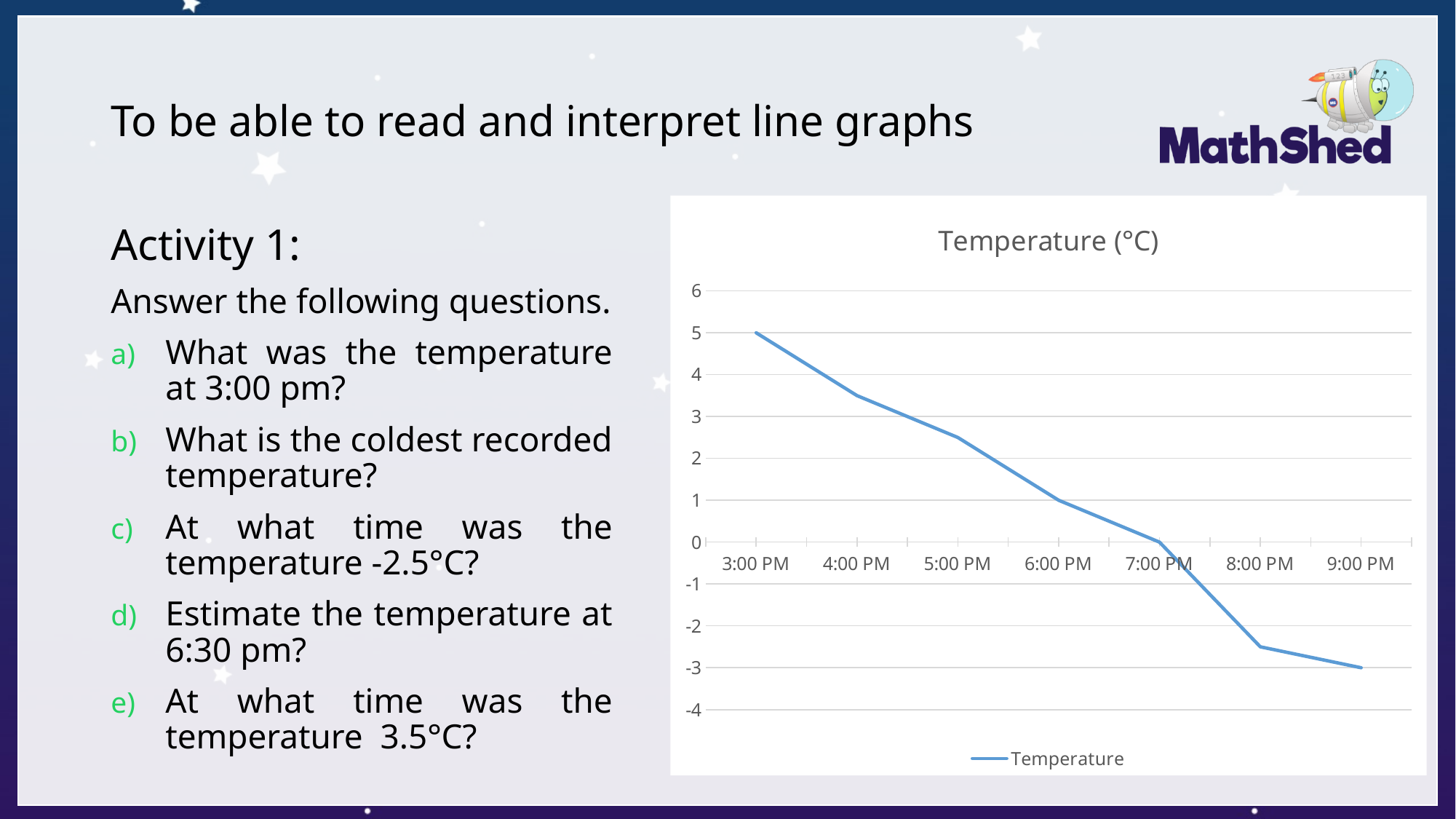
What was the temperature at 9:00 PM? -3 What is the difference between the temperature at 3:00 PM and at 9:00 PM? 8 What was the temperature at 3:00 PM? 5 At which time was the temperature lowest? 9:00 PM Is the temperature at 4:00 PM greater or less than 4? less What was the temperature at 7:00 PM? 0 Does the temperature rise or fall from 3:00 PM to 9:00 PM? fall Is the temperature at 8:00 PM greater or less than -2? less What type of chart is shown on the slide? line chart At which time was the temperature highest? 3:00 PM What is the title of the chart? Temperature (°C) How many time points are plotted on the x axis? 7